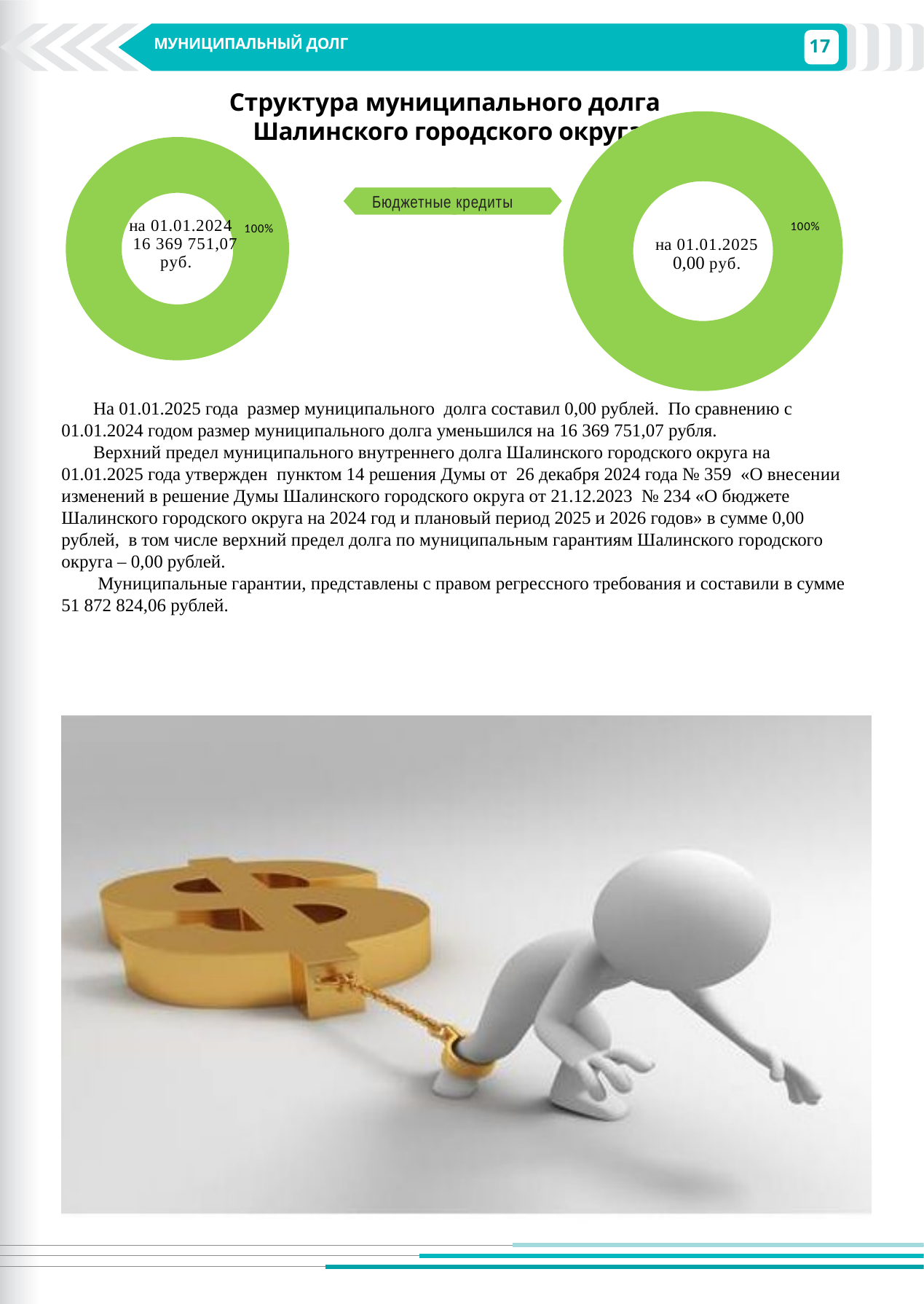
What amount of municipal debt is shown in the centre of the right doughnut chart (на 01.01.2025)? 0,00 руб. How many slices does the left doughnut chart (на 01.01.2024) contain? 1 What is the only legend entry shown between the two doughnut charts? Бюджетные кредиты Which chart shows the larger debt amount: the left one (на 01.01.2024) or the right one (на 01.01.2025)? The left one (на 01.01.2024) In the right doughnut chart (на 01.01.2025), what percentage label is shown on the single slice? 100% What share of the left doughnut chart (на 01.01.2024) is taken by Бюджетные кредиты? 100% What kind of chart is used on the left of the slide to show the municipal debt structure as of 01.01.2024? Doughnut (pie) chart What is the title of the charts on the slide? Структура муниципального долга Шалинского городского округа By how much does the debt amount in the left chart (на 01.01.2024) exceed the amount in the right chart (на 01.01.2025)? 16 369 751,07 руб. What amount of municipal debt is shown in the centre of the left doughnut chart (на 01.01.2024)? 16 369 751,07 руб. In the left doughnut chart (на 01.01.2024), what percentage label is shown on the single slice? 100% How many doughnut charts are shown on the slide? 2